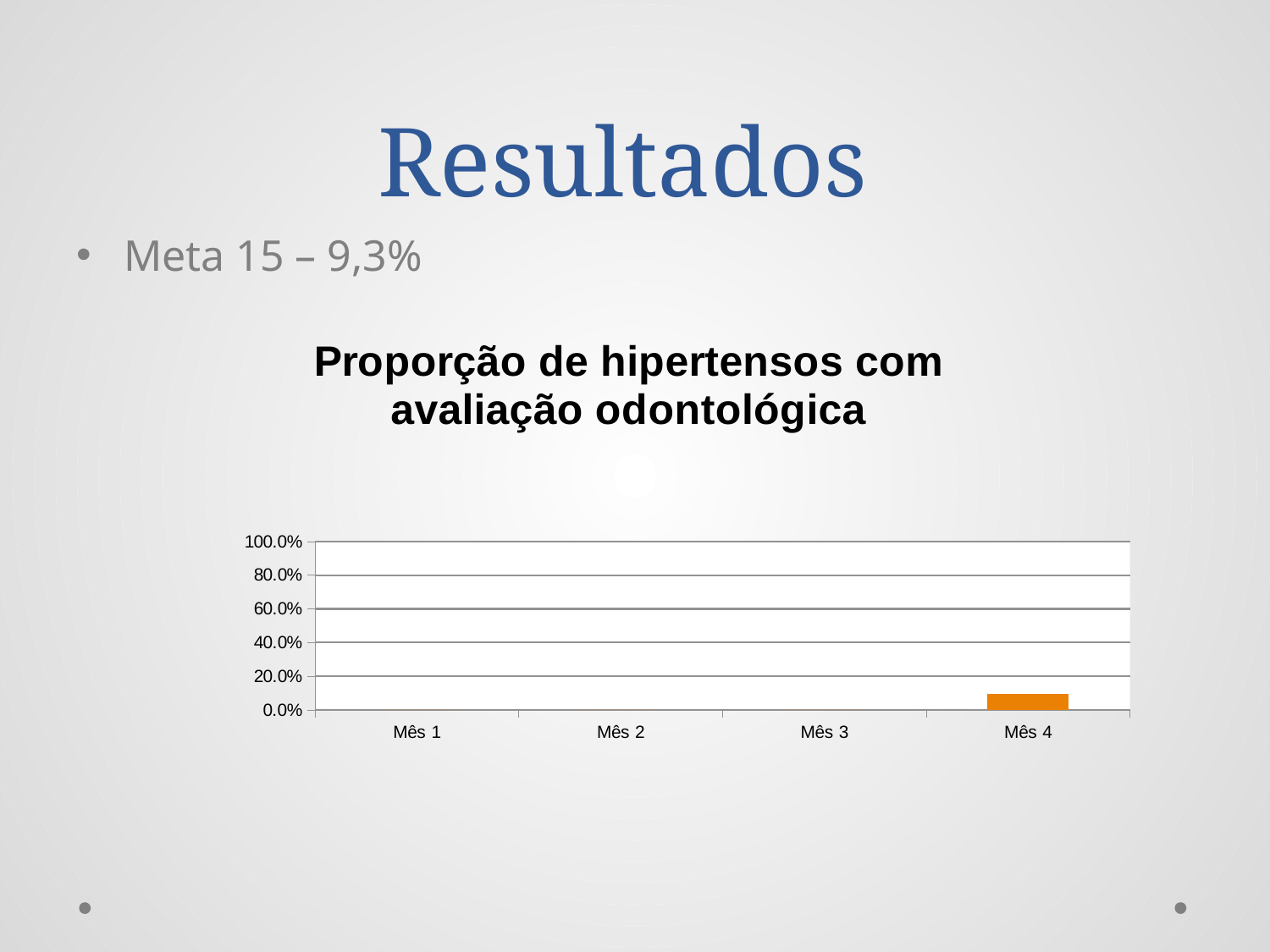
Which is larger, the value for Mês 1 or the value for Mês 4? Mês 4 What kind of chart is shown on the slide? bar chart What is the title of the chart? Proporção de hipertensos com avaliação odontológica What is the highest value shown on the y axis of the chart? 100.0% Is the value for Mês 4 greater or less than 40.0%? less How many categories (months) are shown on the x axis of the chart? 4 Which month has the highest value in the chart? Mês 4 Which is larger, the value for Mês 3 or the value for Mês 4? Mês 4 Do the values rise or fall from Mês 3 to Mês 4? rise Is the value for Mês 4 greater or less than 20.0%? less How many months show a visible bar in the chart? 1